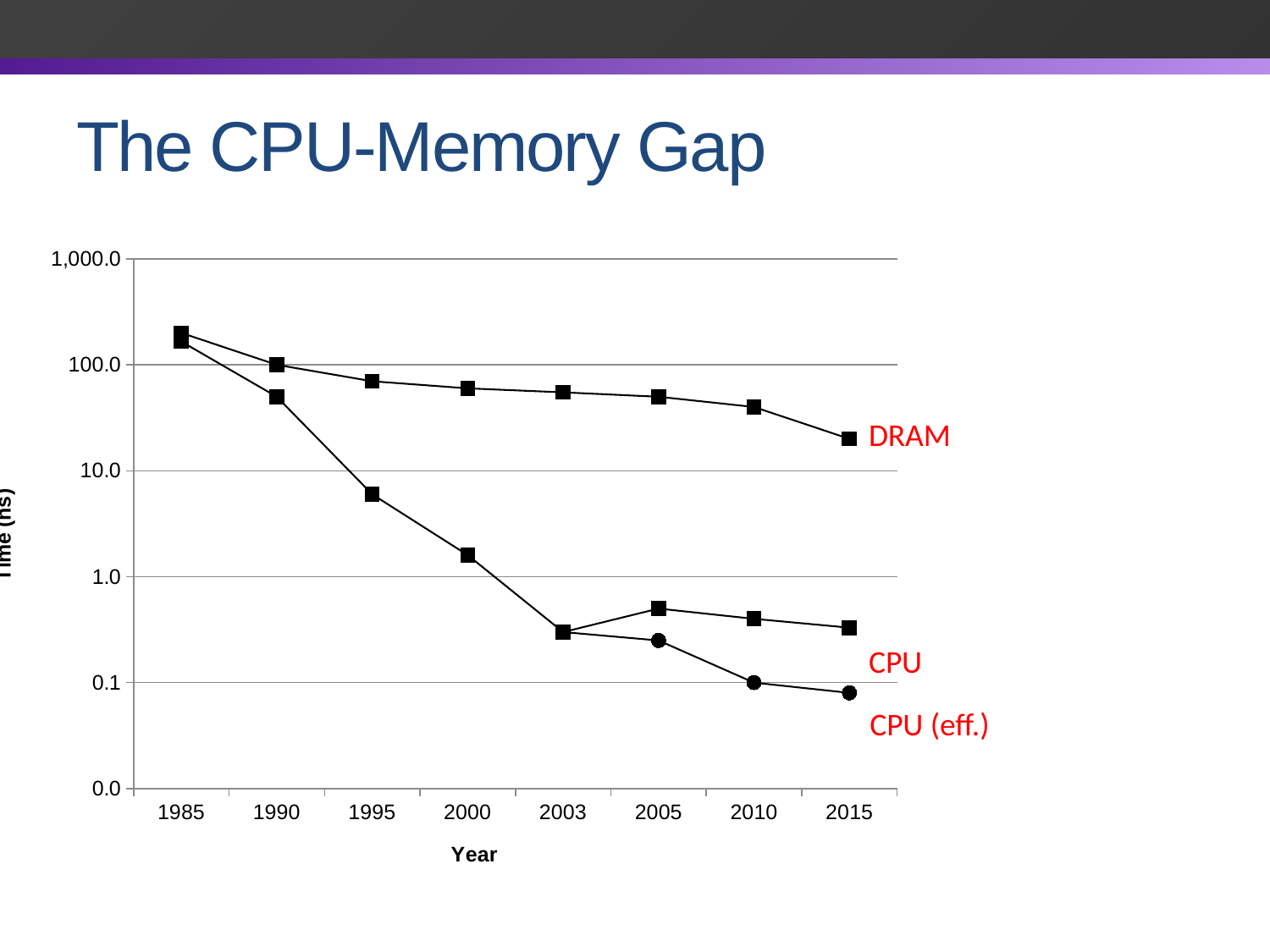
Is the CPU value for 2000 greater or less than 1.0? greater Is the DRAM value for 1985 greater or less than 100.0? greater Do the DRAM values rise or fall from 1985 to 2015? fall What is the title of the slide? The CPU-Memory Gap Is the CPU value for 1995 greater or less than 10.0? less What is the title of the chart's x axis? Year What kind of chart is shown on the slide? line chart Which series has the higher value in 2015, DRAM or CPU? DRAM How many data series are labelled on the chart? 3 How many years are marked on the x axis of the chart? 8